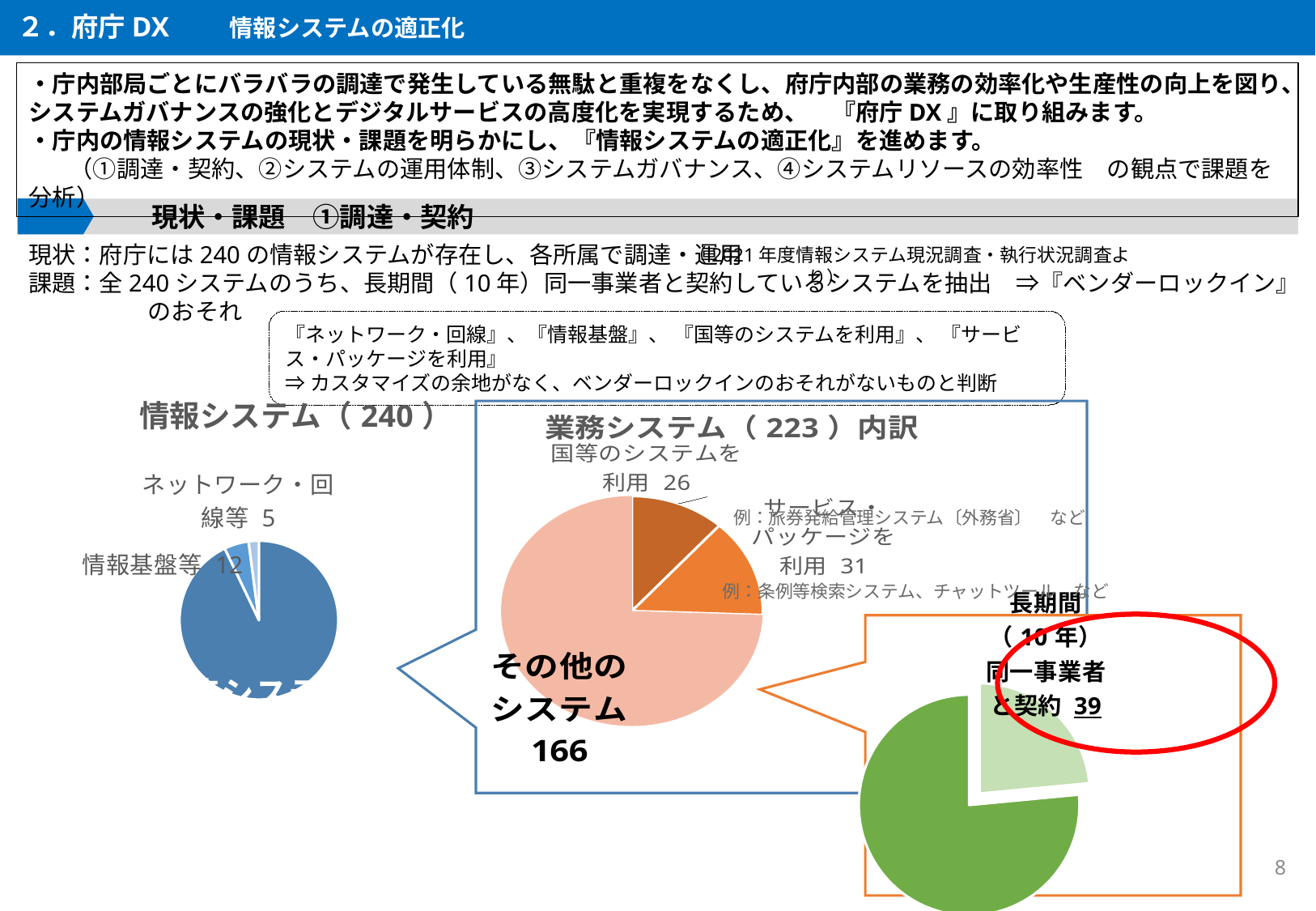
How many slices does the 業務システム（223）内訳 pie chart have? 3 In the 業務システム（223）内訳 chart, what is the value for サービス・パッケージを利用? 31 In the 業務システム（223）内訳 chart, which category has the smallest slice? 国等のシステムを利用 In the 情報システム（240） chart, what is the value for 情報基盤等? 12 In the 情報システム（240） chart, which is larger, 情報基盤等 or ネットワーク・回線等? 情報基盤等 What kind of chart is the 情報システム（240） chart on the left of the slide? pie chart In the 業務システム（223）内訳 chart, which category has the largest slice? その他のシステム In the 業務システム（223）内訳 chart, what is the value for その他のシステム? 166 In the 業務システム（223）内訳 chart, what is the difference between サービス・パッケージを利用 and 国等のシステムを利用? 5 In the 業務システム（223）内訳 chart, what is the value for 国等のシステムを利用? 26 In the green pie chart at the bottom right, what is the value for 長期間（10年）同一事業者と契約? 39 In the 情報システム（240） chart, what is the value for ネットワーク・回線等? 5